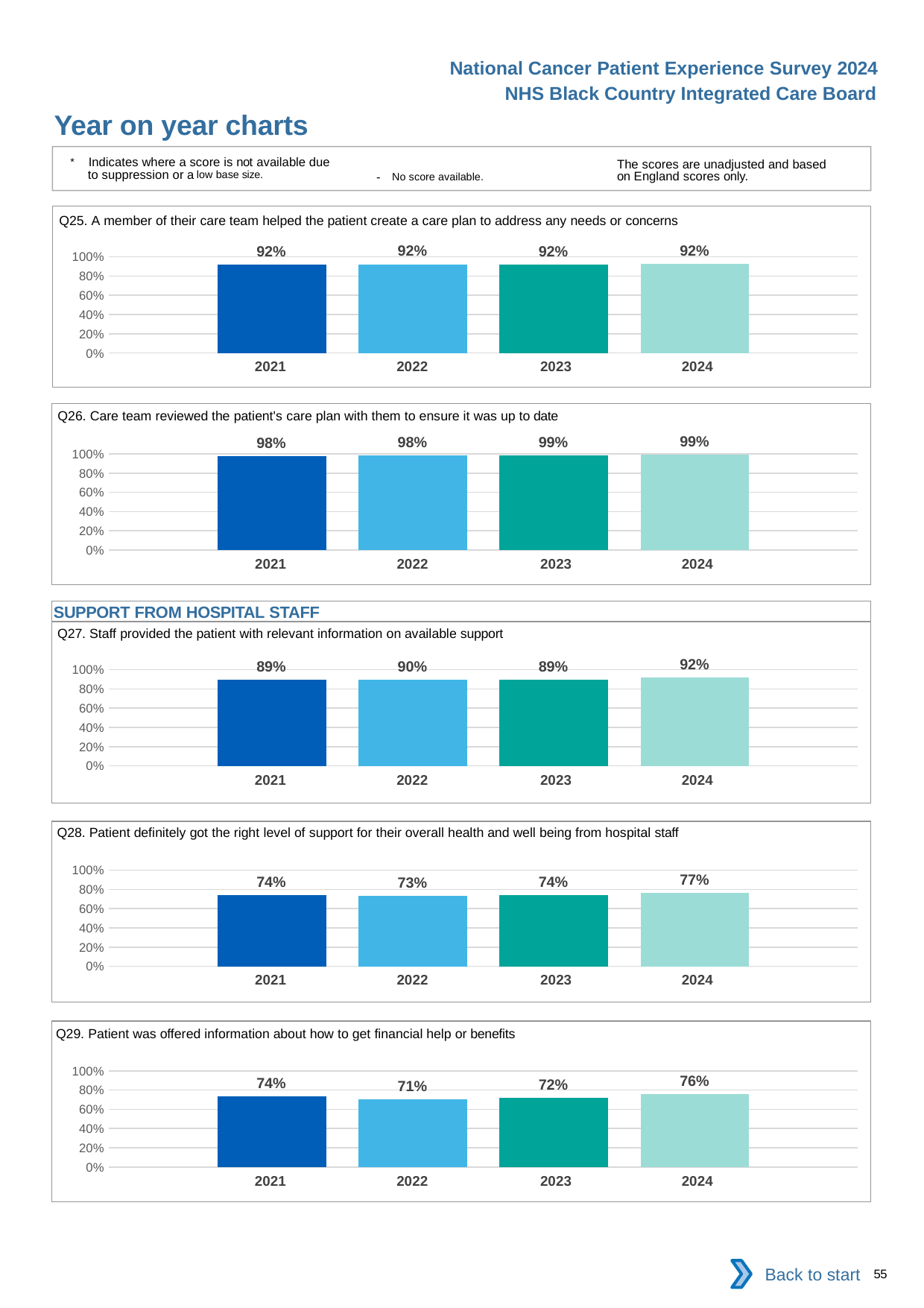
In the Q28 chart, which year has the lowest value? 2022 In the Q27 chart, what is the value for 2022? 90% In the Q29 chart, what is the difference between the 2024 and 2022 values? 5% In the Q26 chart, what is the value for 2021? 98% In the Q28 chart, which is larger, the value for 2024 or the value for 2021? 2024 How many charts are shown on the slide? 5 In the Q29 chart, is the value for 2021 greater or less than 60%? greater How many years are shown in the Q27 chart? 4 What kind of chart is the Q26 chart? bar chart In the Q27 chart, which year has the highest value? 2024 In the Q25 chart, what is the value for 2024? 92% In the Q29 chart, what is the value for 2023? 72%